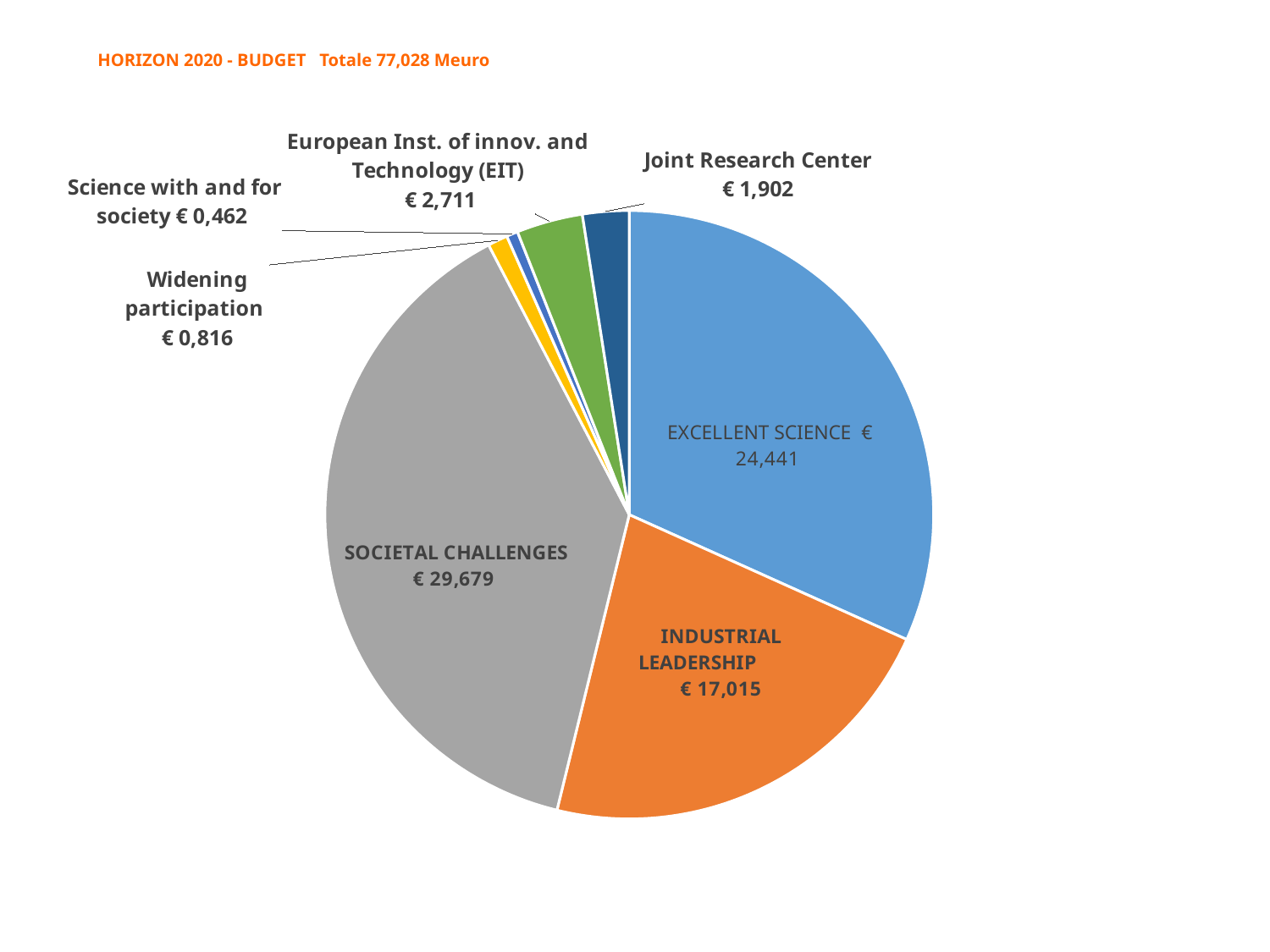
Which is larger, the value for Excellent Science or the value for Industrial Leadership? Excellent Science Which category has the largest slice of the pie? Societal Challenges What is the budget value shown for the Joint Research Center? € 1,902 What total budget is stated in the chart title? 77,028 Meuro How many slices does the pie chart have? 7 Which category has the smallest slice of the pie? Science with and for society What is the budget value shown for Excellent Science? € 24,441 What kind of chart is shown on the slide? Pie chart What is the budget value shown for Widening participation? € 0,816 What is the budget value shown for Industrial Leadership? € 17,015 What is the budget value shown for Societal Challenges? € 29,679 What is the difference between the Societal Challenges value and the Excellent Science value? € 5,238